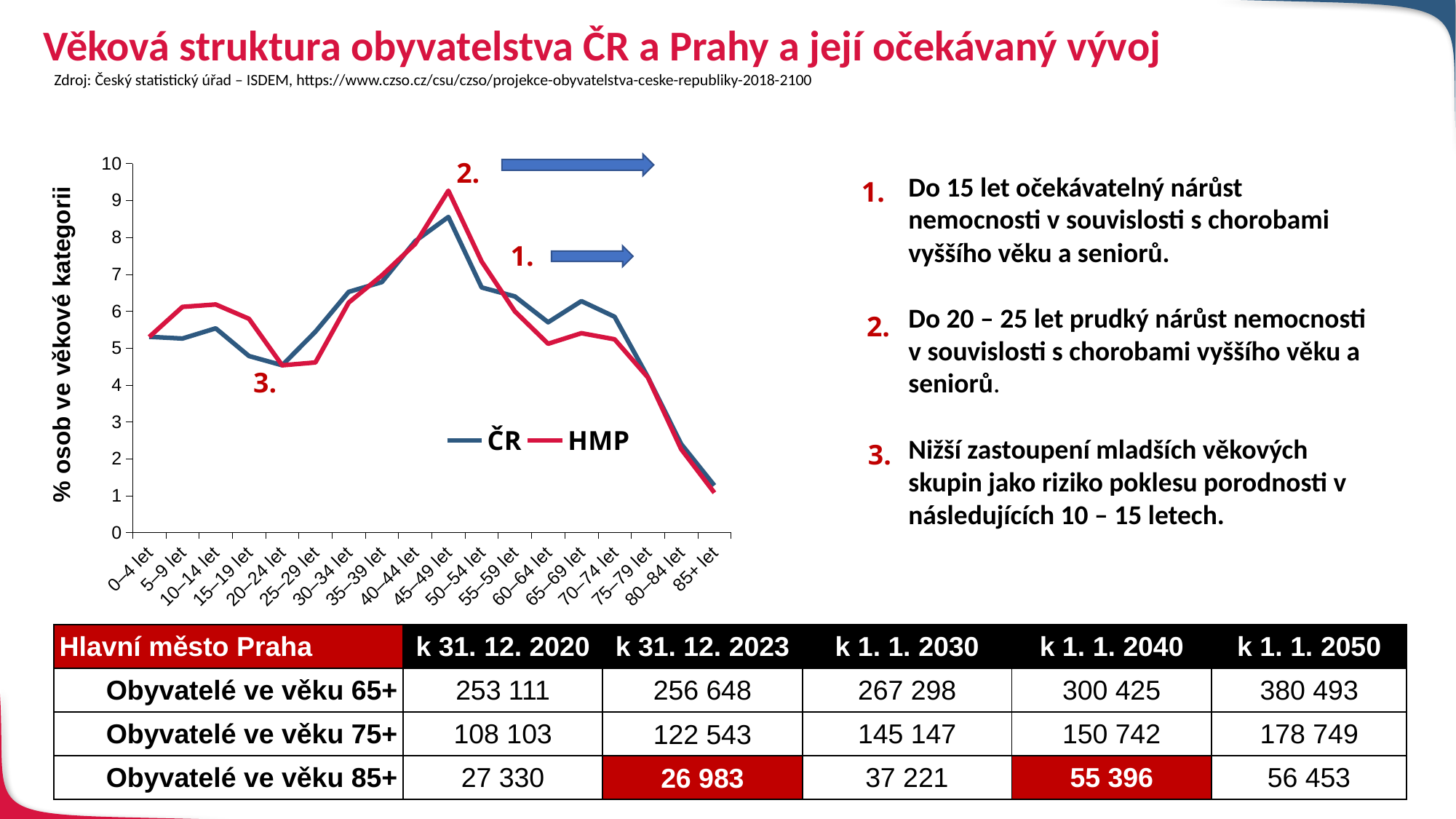
Do the values of the HMP series rise or fall from 45–49 let to 85+ let? fall For which age category is the ČR series lowest? 85+ let How many series does the chart's legend list? 2 How many age categories are plotted along the x axis of the chart? 18 Is the HMP value for 45–49 let greater or less than 8? greater What kind of chart is shown on the slide? line chart Is the ČR value for 20–24 let greater or less than 5? less At 65–69 let, which series has the higher value, ČR or HMP? ČR Is the ČR value for 85+ let greater or less than 2? less At 10–14 let, which series has the higher value, ČR or HMP? HMP For which age category does the ČR series reach its highest value? 45–49 let For which age category does the HMP series reach its highest value? 45–49 let